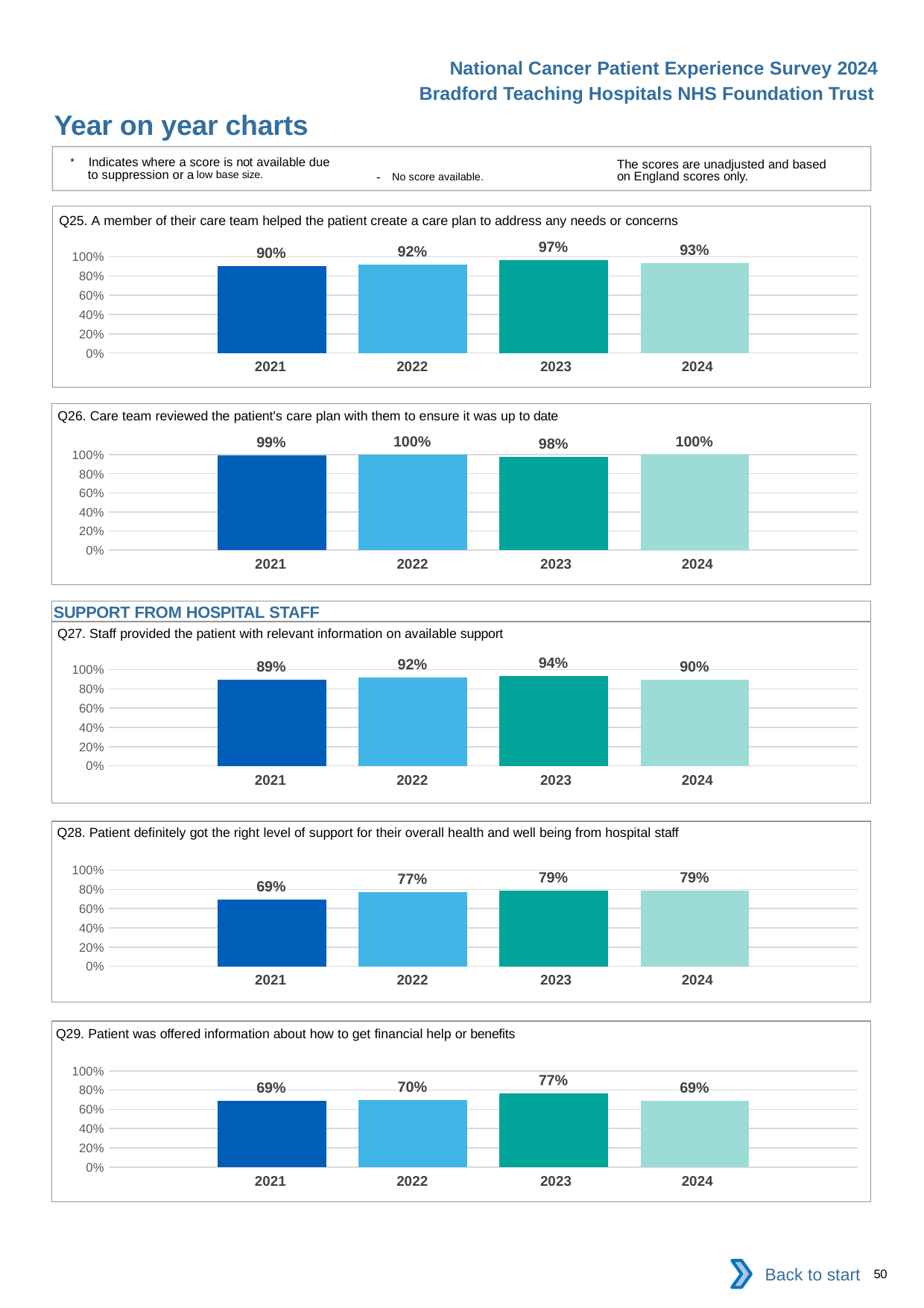
In the Q28 chart (right level of support for overall health and well being), do the values rise or fall from 2021 to 2023? Rise In the Q26 chart (care team reviewed the patient's care plan), what is the value for 2024? 100% What kind of chart is the Q26 chart (care team reviewed the patient's care plan)? Bar chart What is the section heading shown above the Q27 chart? SUPPORT FROM HOSPITAL STAFF How many years are plotted in the Q25 chart (care plan to address needs or concerns)? 4 In the Q29 chart (information about financial help or benefits), which year has the highest value? 2023 In the Q27 chart (relevant information on available support), what is the difference between the 2023 and 2021 values? 5% In the Q25 chart (care plan to address needs or concerns), what is the value for 2023? 97% In the Q28 chart (right level of support for overall health and well being), what is the value for 2021? 69% In the Q26 chart (care team reviewed the patient's care plan), which year has the lowest value? 2023 In the Q28 chart (right level of support for overall health and well being), is the value for 2022 larger than the value for 2021? Yes In the Q29 chart (information about financial help or benefits), is the value for 2024 greater or less than 80%? less